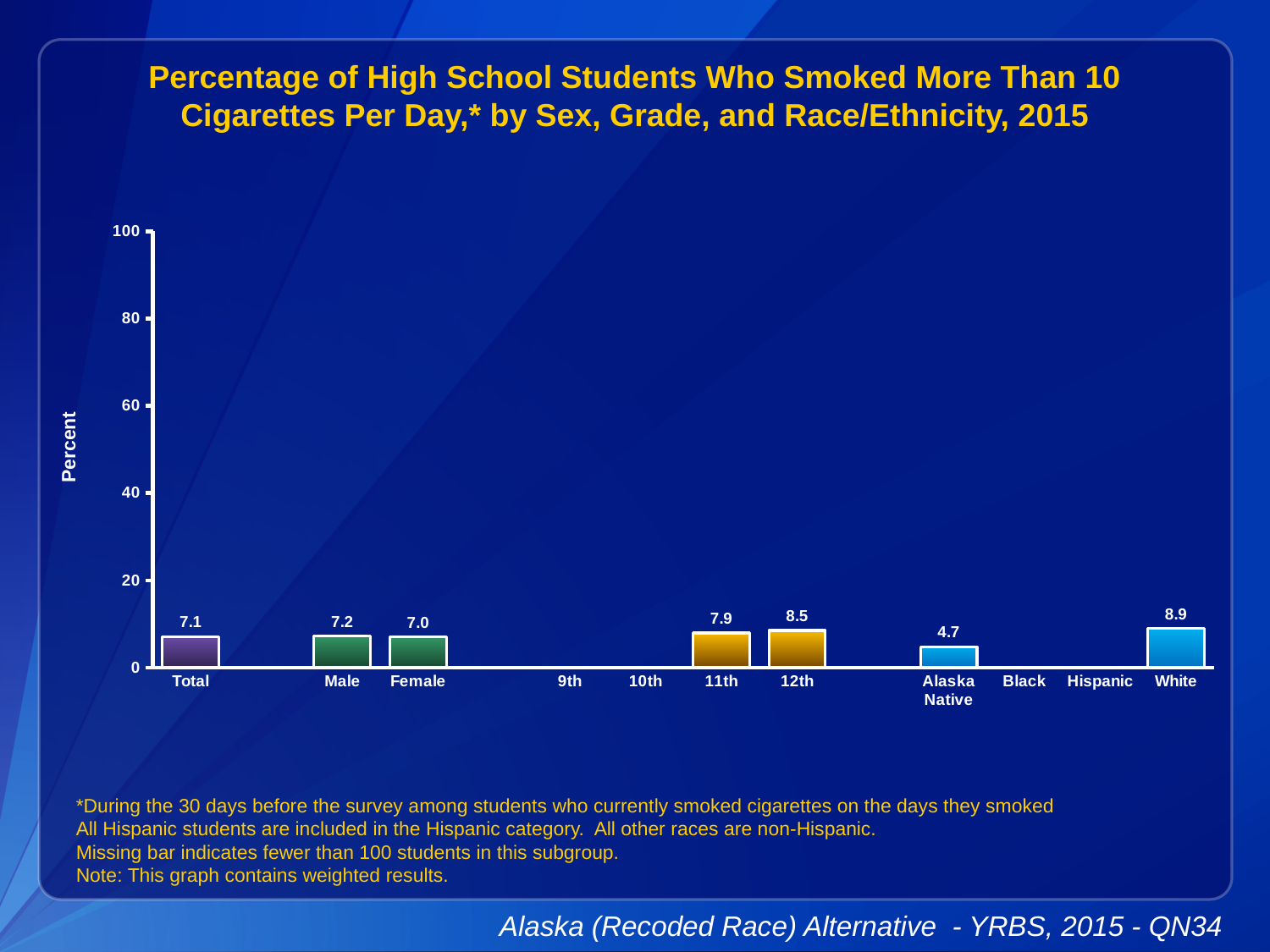
What is the value for Male? 7.2 Which category has the highest value? White What is the label on the y axis? Percent Which is larger, the value for Male or the value for Female? Male Which category with a bar has the lowest value? Alaska Native What is the value for Total? 7.1 What is the value for Alaska Native? 4.7 What is the difference between the values for 12th and 11th grade? 0.6 What kind of chart is shown? bar chart What is the value for 12th grade? 8.5 Is the value for White greater or less than 20? less How many categories are labeled on the x axis? 11